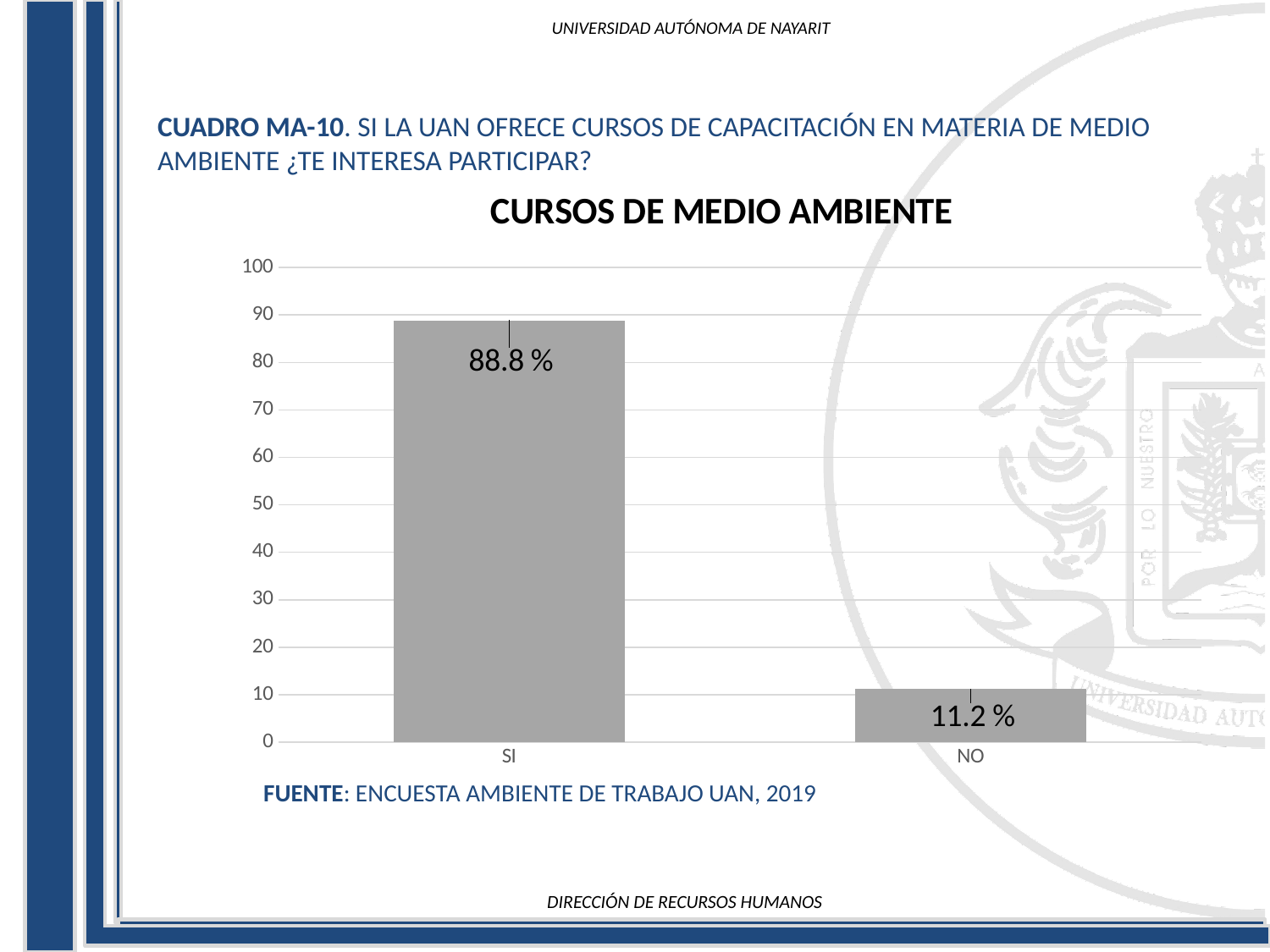
What is the value for SI? 88.8 % What is the source cited below the chart? ENCUESTA AMBIENTE DE TRABAJO UAN, 2019 What is the value for NO? 11.2 % Is the value for NO greater or less than 20? less Is the value for SI greater or less than 80? greater What kind of chart is shown? bar chart Which is larger, the value for SI or the value for NO? SI Which category has the highest value? SI What is the difference between the values for SI and NO? 77.6 % What is the title of the chart? CURSOS DE MEDIO AMBIENTE How many categories are shown on the x axis? 2 Which category has the lowest value? NO